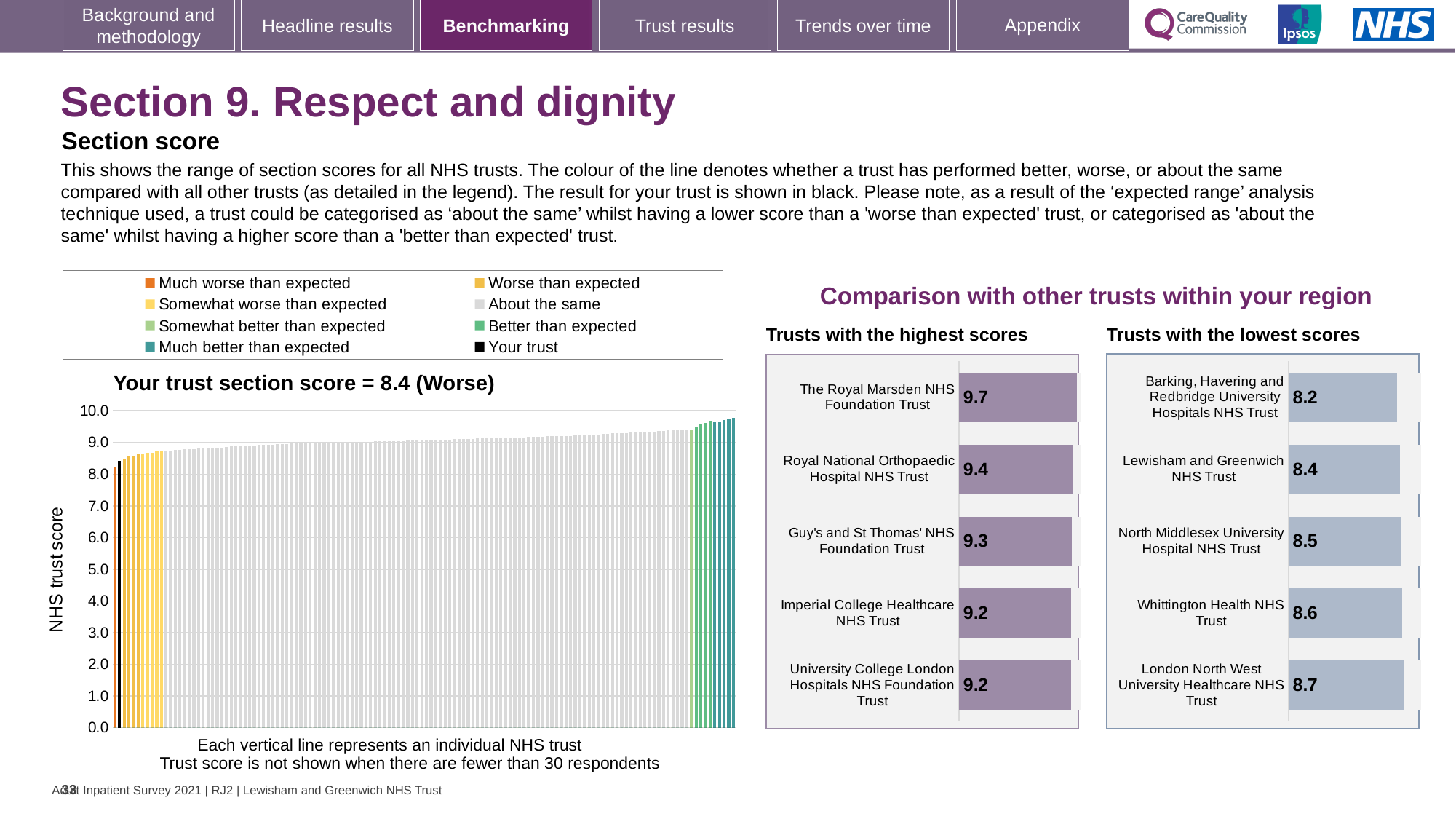
In the 'Trusts with the highest scores' chart, what is the difference between the scores of The Royal Marsden NHS Foundation Trust and Imperial College Healthcare NHS Trust? 0.5 In the 'Trusts with the lowest scores' chart, what is the score for London North West University Healthcare NHS Trust? 8.7 In the 'Trusts with the highest scores' chart, what is the score for Guy's and St Thomas' NHS Foundation Trust? 9.3 What kind of chart is the 'Your trust section score' chart on the left? Bar chart How many entries does the legend above the 'Your trust section score' chart list? 8 In the 'Trusts with the highest scores' chart, what is the score for The Royal Marsden NHS Foundation Trust? 9.7 In the 'Trusts with the lowest scores' chart, which trust has the lowest score? Barking, Havering and Redbridge University Hospitals NHS Trust In the 'Trusts with the lowest scores' chart, what is the score for Barking, Havering and Redbridge University Hospitals NHS Trust? 8.2 How many trusts are shown in the 'Trusts with the lowest scores' chart? 5 In the 'Trusts with the lowest scores' chart, which has the higher score: Whittington Health NHS Trust or Lewisham and Greenwich NHS Trust? Whittington Health NHS Trust In the 'Your trust section score' chart, do the bar heights rise or fall from left to right? Rise In the 'Trusts with the highest scores' chart, which trust has the highest score? The Royal Marsden NHS Foundation Trust